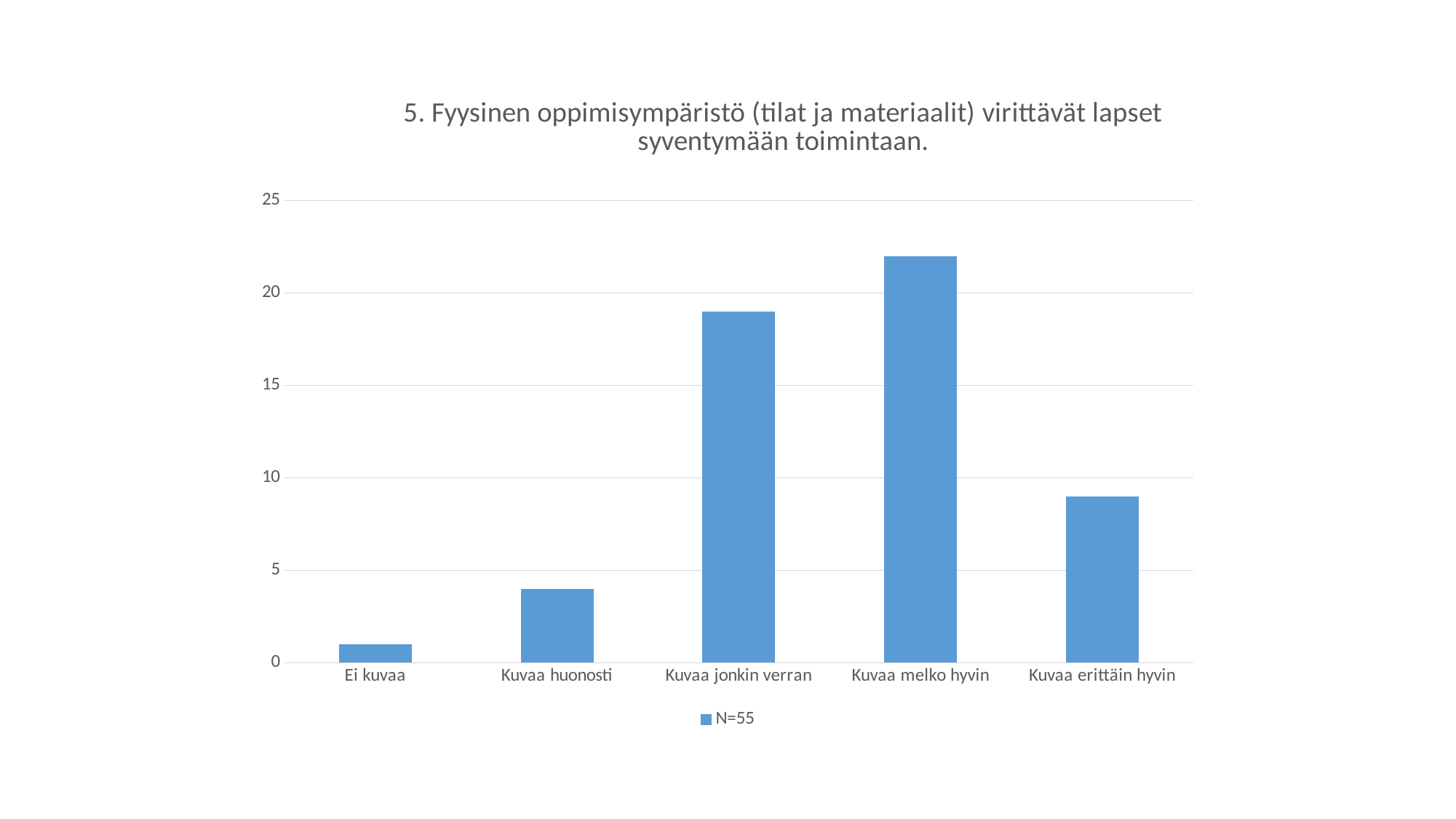
Is the value for Kuvaa erittäin hyvin greater or less than 10? less Which is larger, the value for Kuvaa jonkin verran or the value for Kuvaa erittäin hyvin? Kuvaa jonkin verran How many categories are shown on the x axis? 5 What is the legend entry shown below the chart? N=55 Which category has the highest value? Kuvaa melko hyvin Which is larger, the value for Kuvaa huonosti or the value for Ei kuvaa? Kuvaa huonosti Is the value for Kuvaa jonkin verran greater or less than 20? less Which category has the lowest value? Ei kuvaa Is the value for Kuvaa melko hyvin greater or less than 20? greater How many series does the legend list? 1 What kind of chart is shown on the slide? bar chart